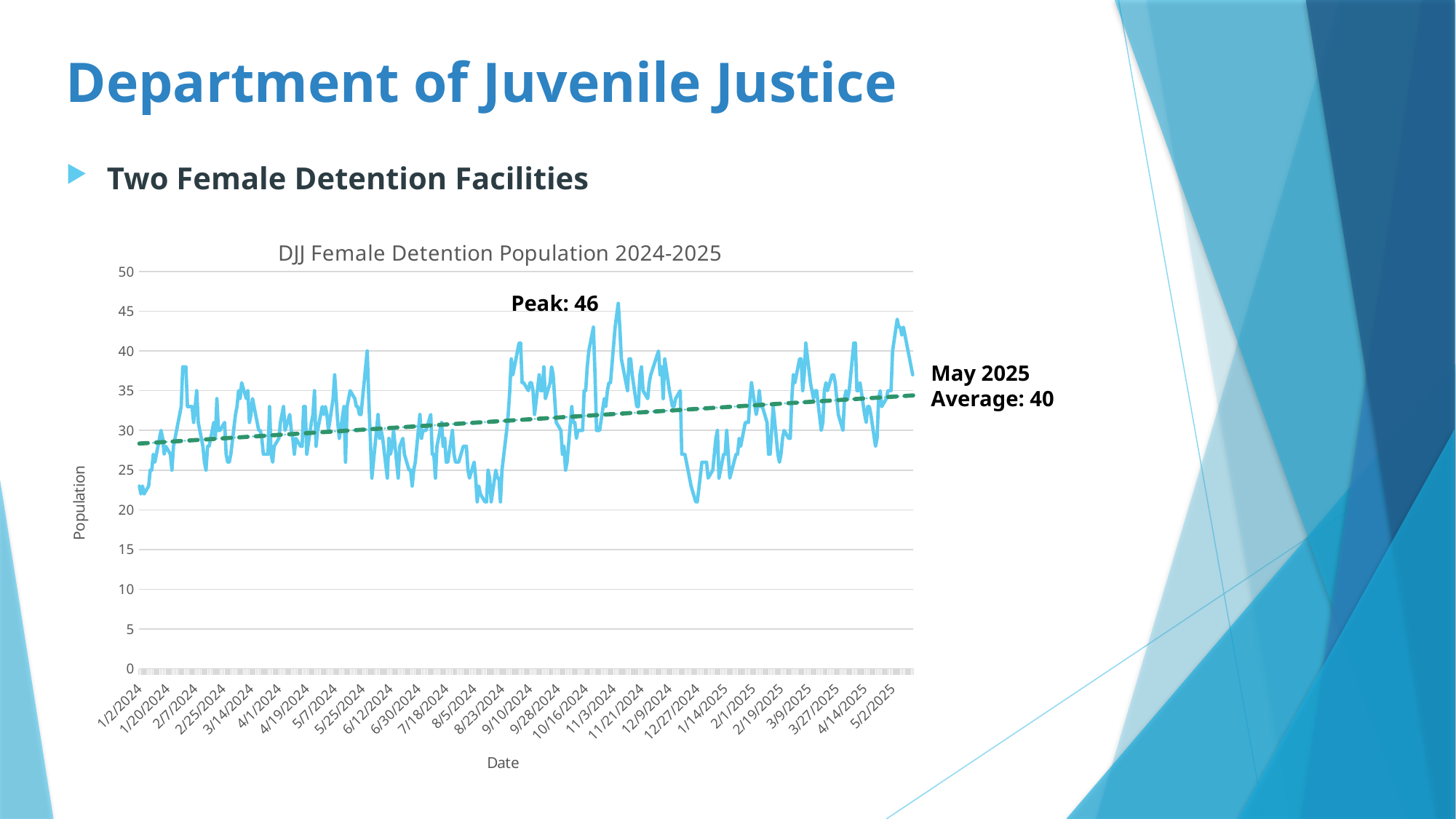
Is the May 2025 average of 40 greater or less than 35? greater What is the peak value labelled on the chart? 46 Is the population value at the start of the chart (1/2/2024) greater or less than 25? less Is the lowest dip in the line around late December 2024 greater or less than 25? less What is the label on the vertical axis of the chart? Population Does the dashed trend line rise or fall from left to right across the chart? rise What is the May 2025 average labelled on the chart? 40 What is the title of the chart? DJJ Female Detention Population 2024-2025 What is the highest value shown on the vertical axis? 50 What kind of chart is shown on the slide? line chart